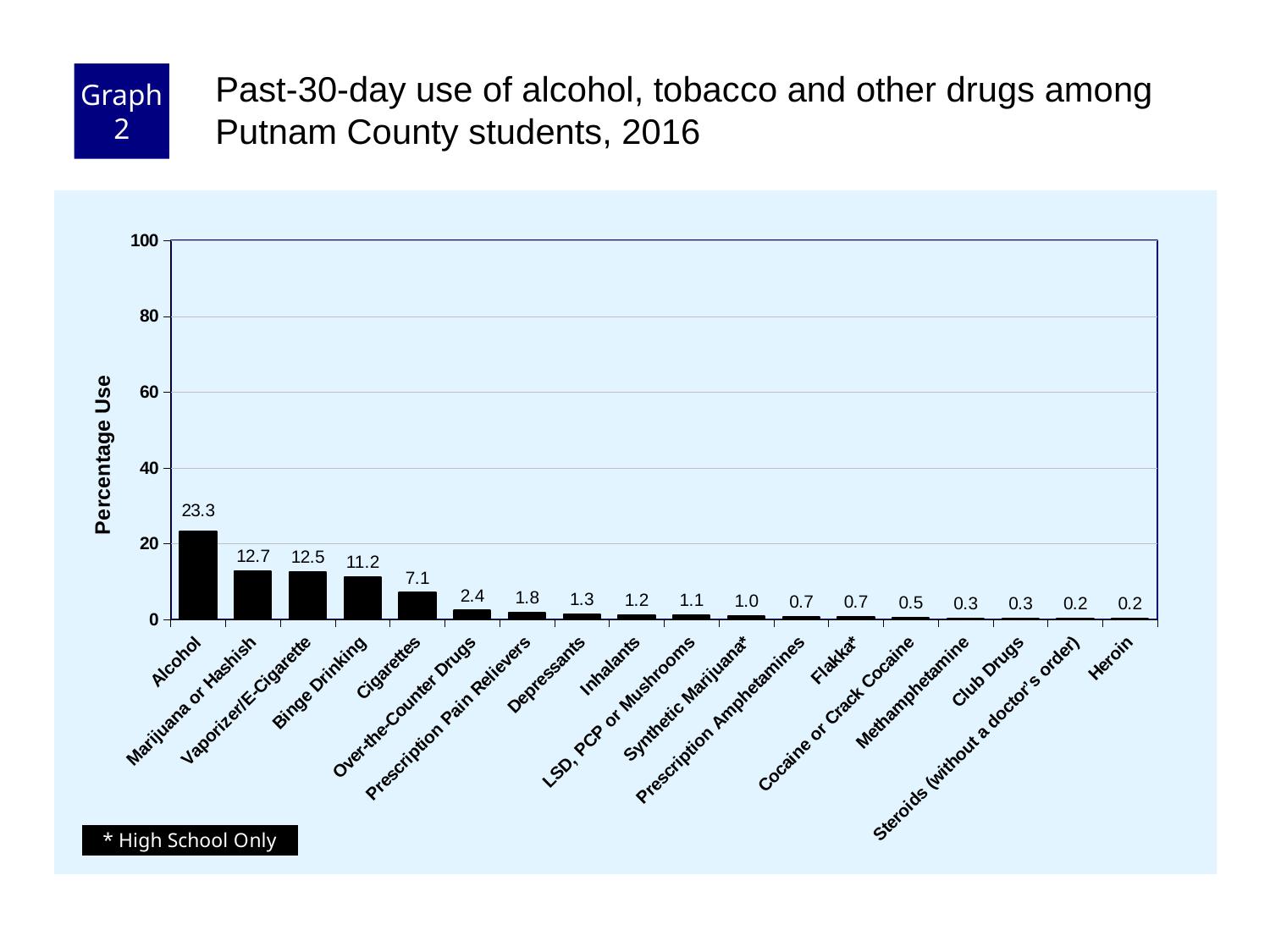
How much higher is the value for Marijuana or Hashish than for Vaporizer/E-Cigarette? 0.2 What kind of chart is shown on the slide? Bar chart Which substance has the highest past-30-day use percentage? Alcohol How many substance categories are shown on the x axis? 18 What is the difference between the values for Alcohol and Marijuana or Hashish? 10.6 What value is shown for Cigarettes? 7.1 What is the title of the y axis? Percentage Use What is the value for Over-the-Counter Drugs? 2.4 What is the past-30-day use percentage for Alcohol? 23.3 Which is larger, the value for Binge Drinking or the value for Cigarettes? Binge Drinking What value is shown for Heroin? 0.2 Do the values rise or fall moving from left to right along the x axis? Fall